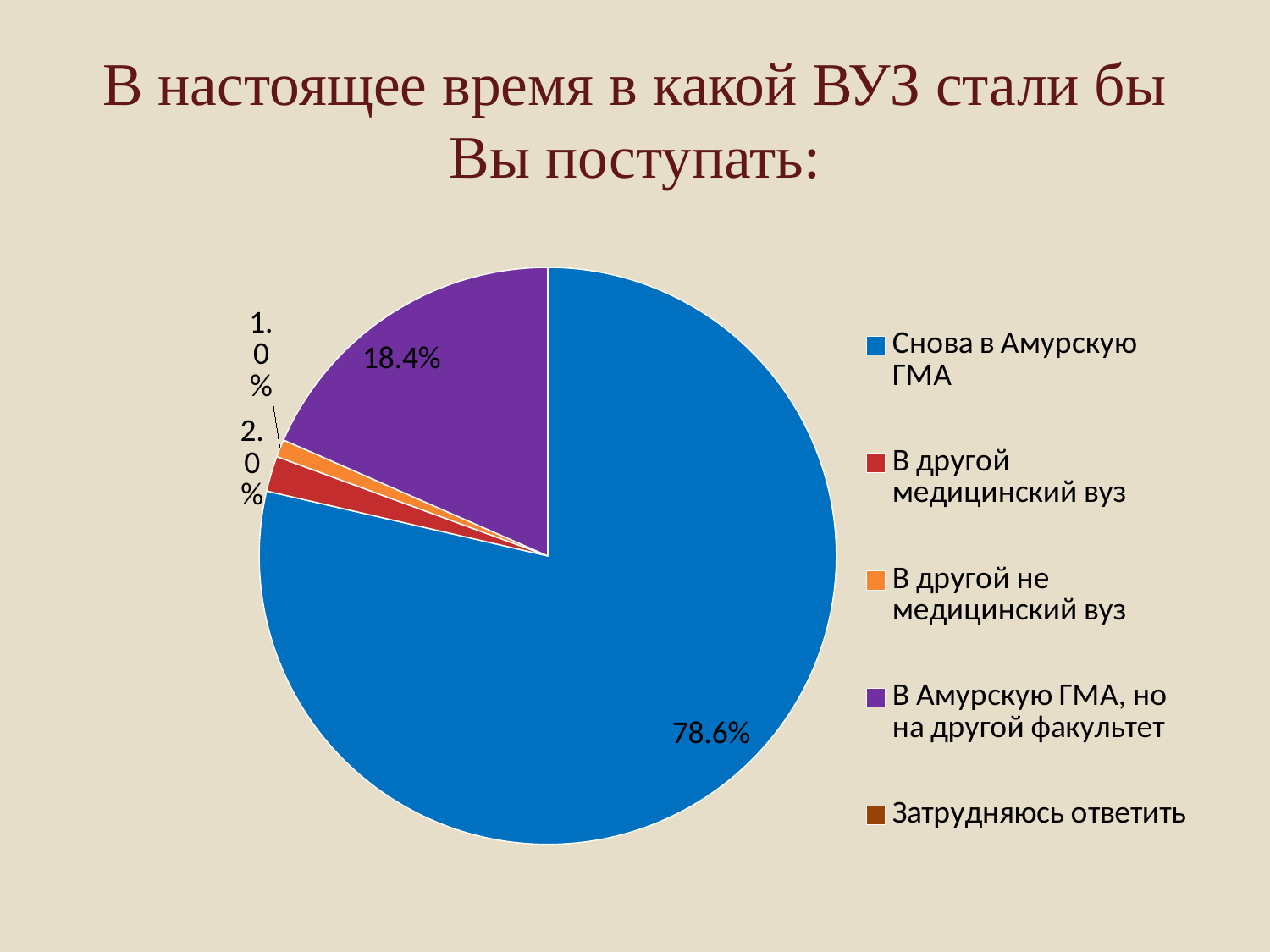
What is the difference in percentage points between "Снова в Амурскую ГМА" and "В Амурскую ГМА, но на другой факультет"? 60.2 What colour is the slice for "В Амурскую ГМА, но на другой факультет"? purple Which answer option has the largest share of the pie? Снова в Амурскую ГМА How many answer options does the legend list? 5 Is the share for "Снова в Амурскую ГМА" greater or less than 50%? greater What percentage of respondents chose "В другой медицинский вуз"? 2.0% What percentage of respondents chose "Снова в Амурскую ГМА"? 78.6% What is the combined share of "Снова в Амурскую ГМА" and "В Амурскую ГМА, но на другой факультет"? 97.0% Which is larger: the share for "В другой медицинский вуз" or for "В другой не медицинский вуз"? В другой медицинский вуз What percentage of respondents chose "В Амурскую ГМА, но на другой факультет"? 18.4% What type of chart is shown on the slide? pie chart What percentage of respondents chose "В другой не медицинский вуз"? 1.0%